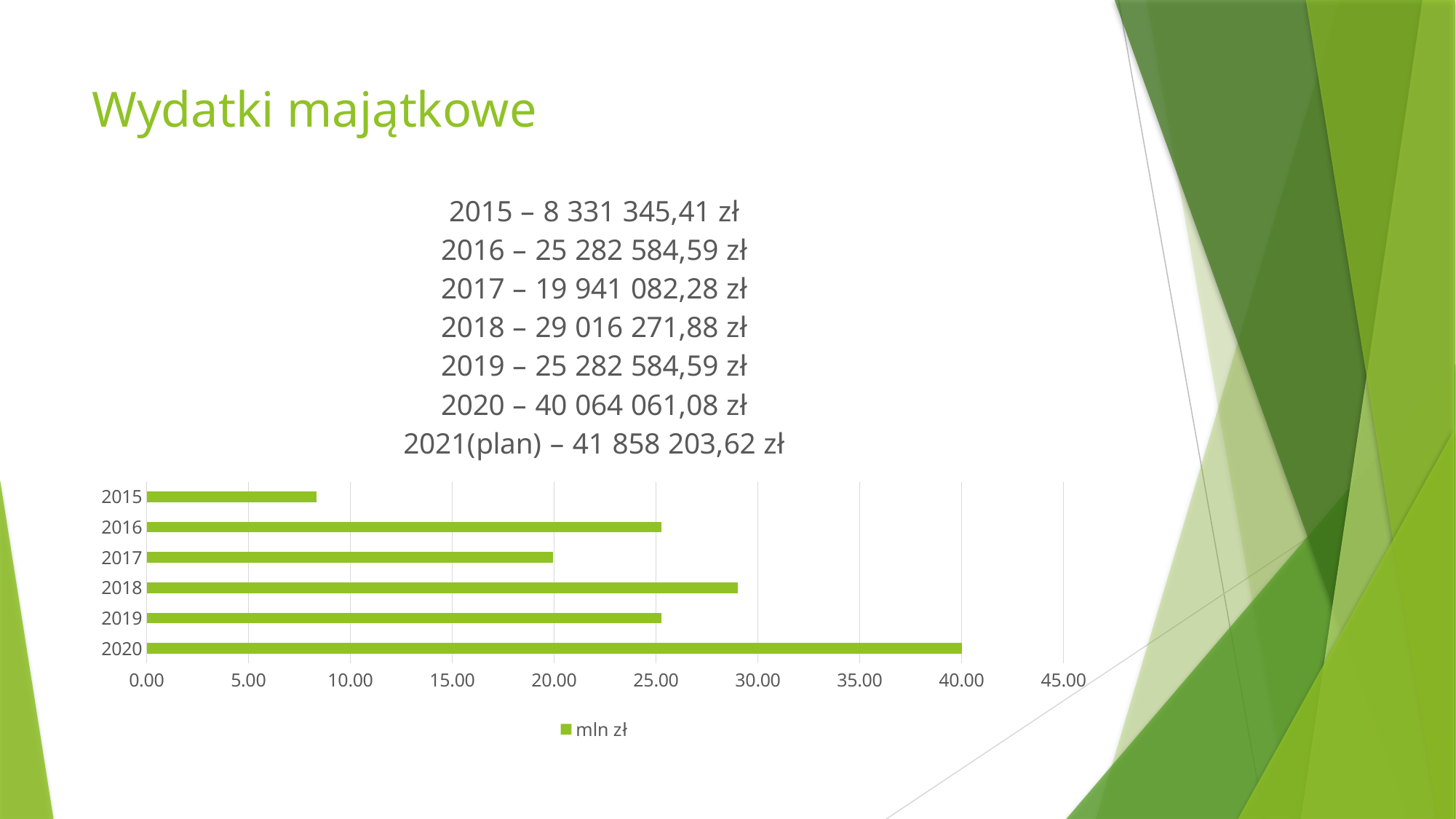
How many series does the chart legend list? 1 What is the title of the slide containing the chart? Wydatki majątkowe How many years are plotted in the chart? 6 Which year has the longest bar in the chart? 2020 Which bar is longer, 2018 or 2017? 2018 Is the bar for 2020 greater or less than 35.00? greater Is the bar for 2015 greater or less than 10.00? less What is the legend entry of the chart? mln zł What kind of chart is shown on the slide? bar chart Which year has the shortest bar in the chart? 2015 Is the bar for 2018 greater or less than 25.00? greater According to the text above the chart, what is the value for 2020? 40 064 061,08 zł